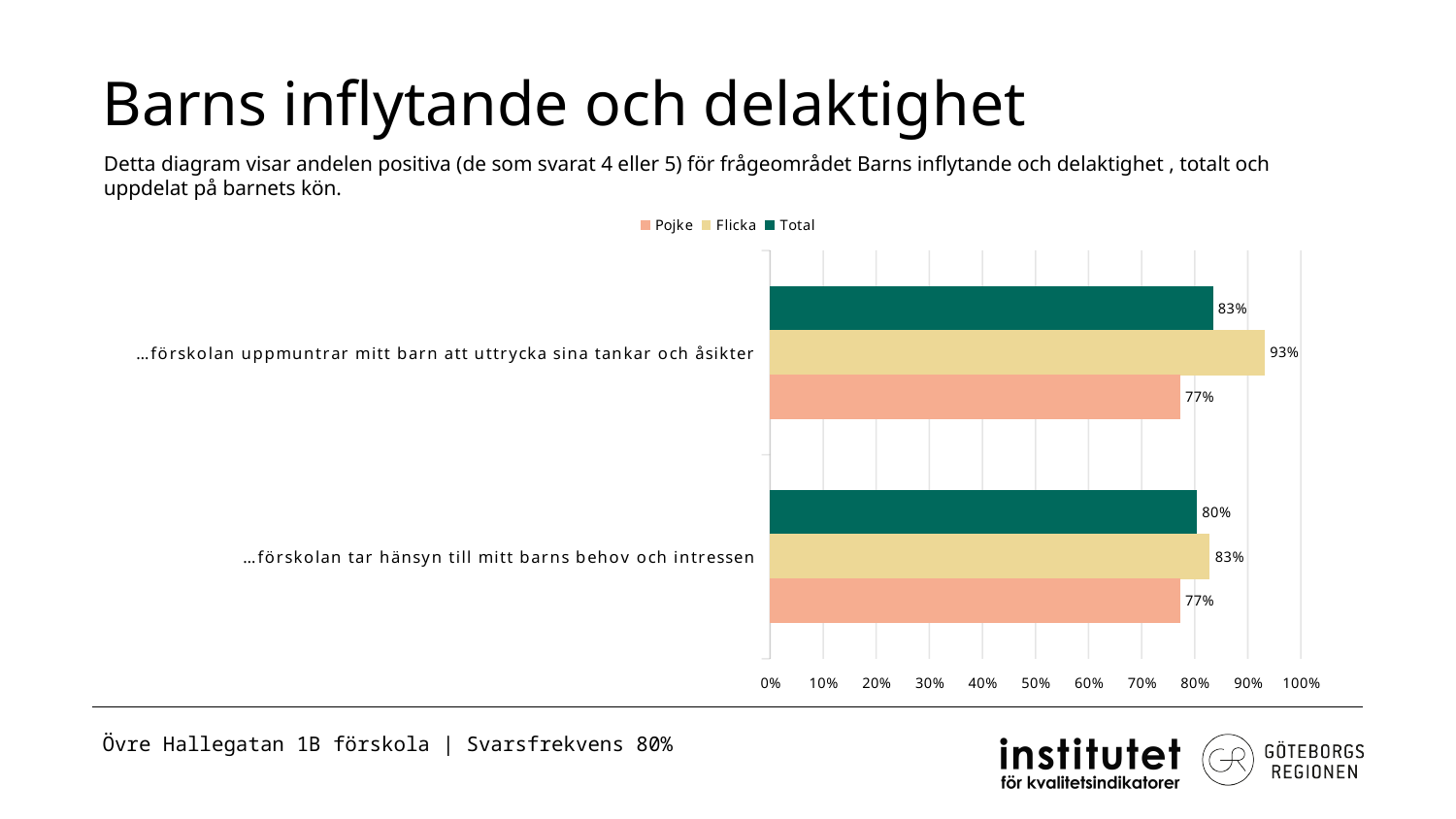
Is the Total value for "…förskolan uppmuntrar mitt barn att uttrycka sina tankar och åsikter" larger or smaller than the Total value for "…förskolan tar hänsyn till mitt barns behov och intressen"? larger What kind of chart is shown on the slide? bar chart What is the difference between the Flicka and Pojke values for "…förskolan uppmuntrar mitt barn att uttrycka sina tankar och åsikter"? 16 percentage points Which series has the lowest value for "…förskolan tar hänsyn till mitt barns behov och intressen"? Pojke What is the Flicka value for "…förskolan tar hänsyn till mitt barns behov och intressen"? 83% What is the difference between the Flicka and Total values for "…förskolan tar hänsyn till mitt barns behov och intressen"? 3 percentage points Which series has the highest value for "…förskolan uppmuntrar mitt barn att uttrycka sina tankar och åsikter"? Flicka How many categories are shown on the chart? 2 What is the Pojke value for "…förskolan uppmuntrar mitt barn att uttrycka sina tankar och åsikter"? 77% What is the Flicka value for "…förskolan uppmuntrar mitt barn att uttrycka sina tankar och åsikter"? 93% What is the Total value for "…förskolan tar hänsyn till mitt barns behov och intressen"? 80% How many series does the legend list? 3